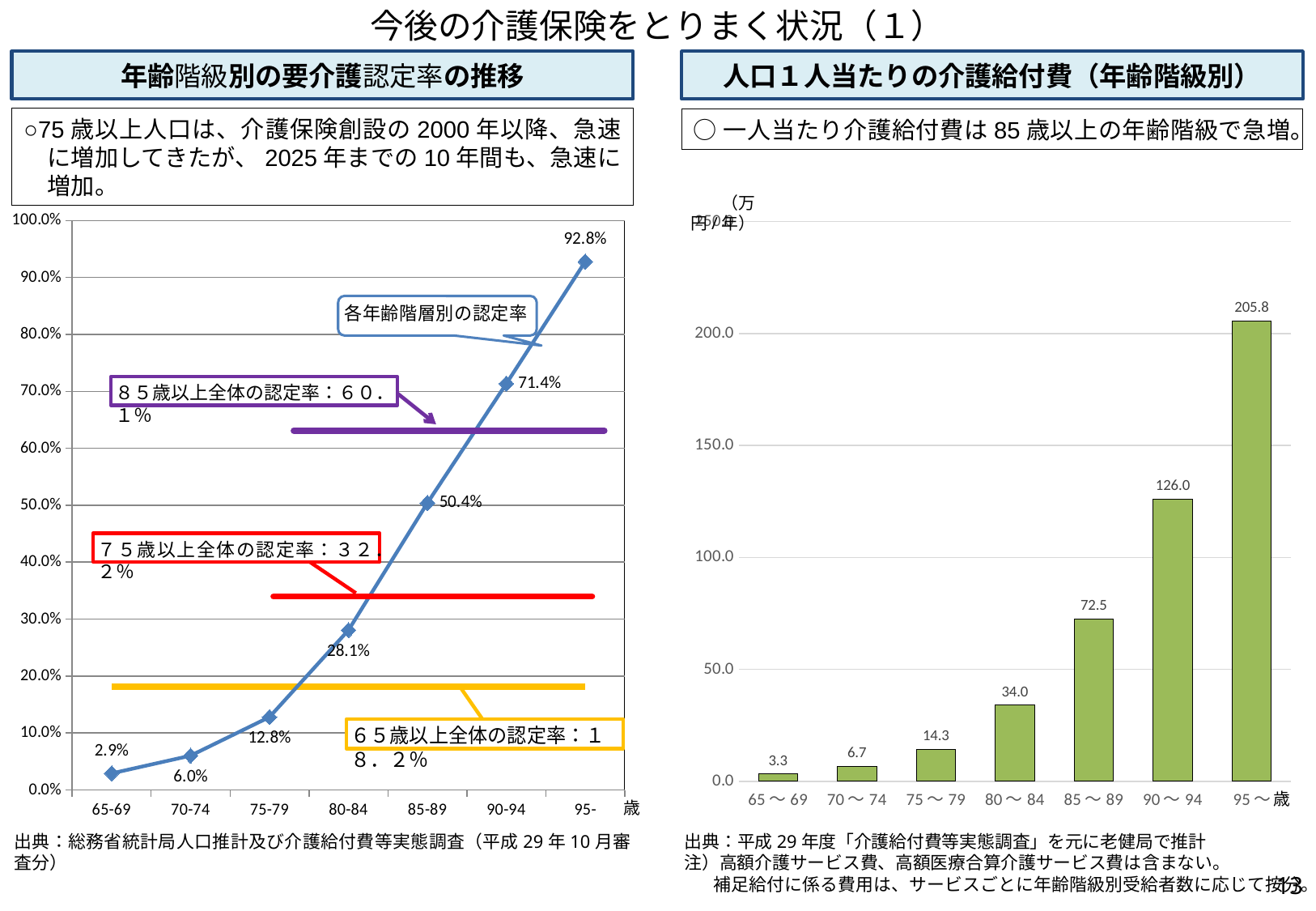
In the left chart (年齢階級別の要介護認定率の推移), what is the certification rate for the 65-69 age group? 2.9% In the right chart (人口１人当たりの介護給付費), what is the difference between the values for 95～ and 90～94? 79.8 What type of chart is the left chart (年齢階級別の要介護認定率の推移)? line chart In the right chart (人口１人当たりの介護給付費), what is the value for the 90～94 age group? 126.0 In the left chart (年齢階級別の要介護認定率の推移), how many age groups are plotted on the x axis? 7 In the left chart (年齢階級別の要介護認定率の推移), what is the difference between the certification rates for 90-94 and 80-84? 43.3% In the left chart (年齢階級別の要介護認定率の推移), which age group has the highest certification rate? 95- In the right chart (人口１人当たりの介護給付費), which is larger, the value for 80～84 or the value for 85～89? 85～89 In the left chart (年齢階級別の要介護認定率の推移), what is the certification rate for the 85-89 age group? 50.4% In the right chart (人口１人当たりの介護給付費), which age group has the lowest value? 65～69 What type of chart is the right chart (人口１人当たりの介護給付費)? bar chart In the left chart (年齢階級別の要介護認定率の推移), do the certification rates rise or fall as age increases along the x axis? rise